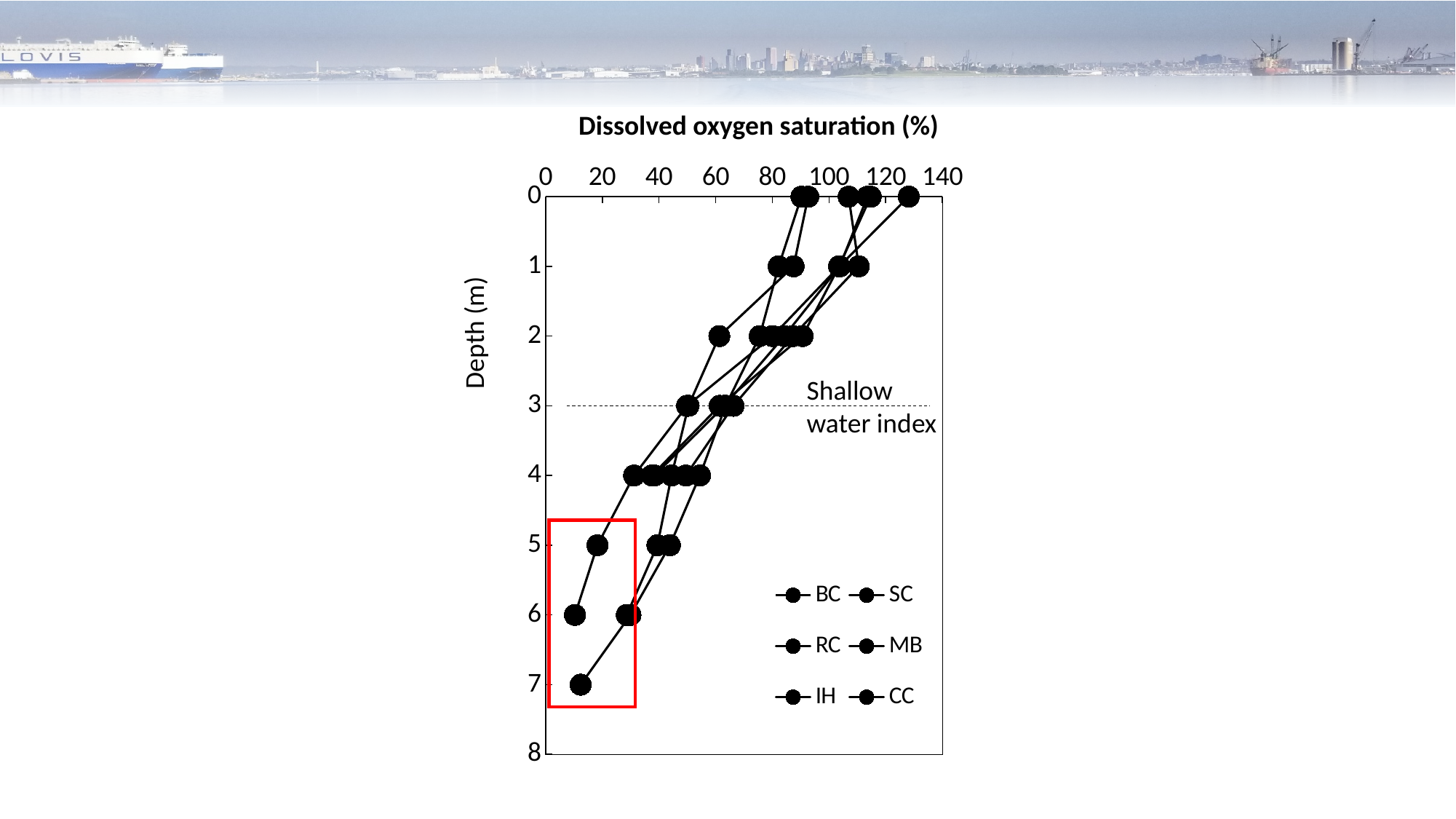
Are the dissolved oxygen saturation values at a depth of 6 m greater or less than 40? less Is the dissolved oxygen saturation value at a depth of 7 m greater or less than 20? less As depth increases, do the dissolved oxygen saturation values rise or fall? fall What kind of chart is shown on the slide? line chart Are the dissolved oxygen saturation values at a depth of 0 m greater or less than 80? greater What is the highest value shown on the dissolved oxygen saturation axis? 140 At what depth is the dashed 'Shallow water index' line drawn? 3 m How many series does the legend list? 6 How many data points are plotted at a depth of 6 m? 2 How many data points are plotted at a depth of 7 m? 1 What is the title of the horizontal axis? Dissolved oxygen saturation (%)